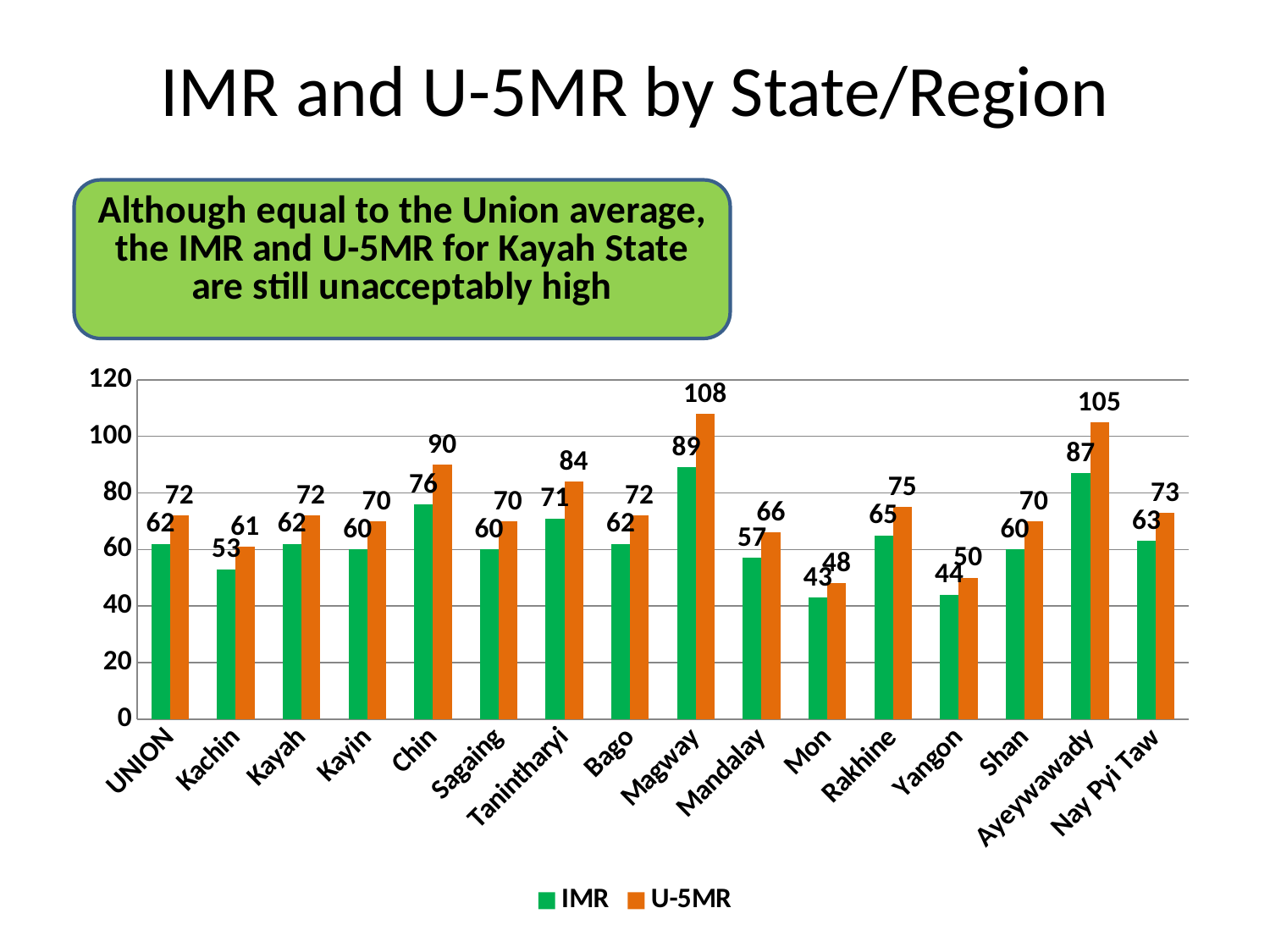
What kind of chart is shown on the slide? bar chart How many series does the legend list? 2 What is the U-5MR value for Ayeywawady? 105 What is the IMR value for Magway? 89 Which state/region has the lowest IMR? Mon Which colour represents the U-5MR series? orange How many states/regions (including UNION) are shown on the x axis? 16 What is the U-5MR value for Kachin? 61 Is the U-5MR value for Tanintharyi greater or less than 80? greater What is the difference between the U-5MR and IMR for Chin? 14 Which state/region has the highest U-5MR? Magway Which is larger, the IMR for Rakhine or the IMR for Shan? Rakhine